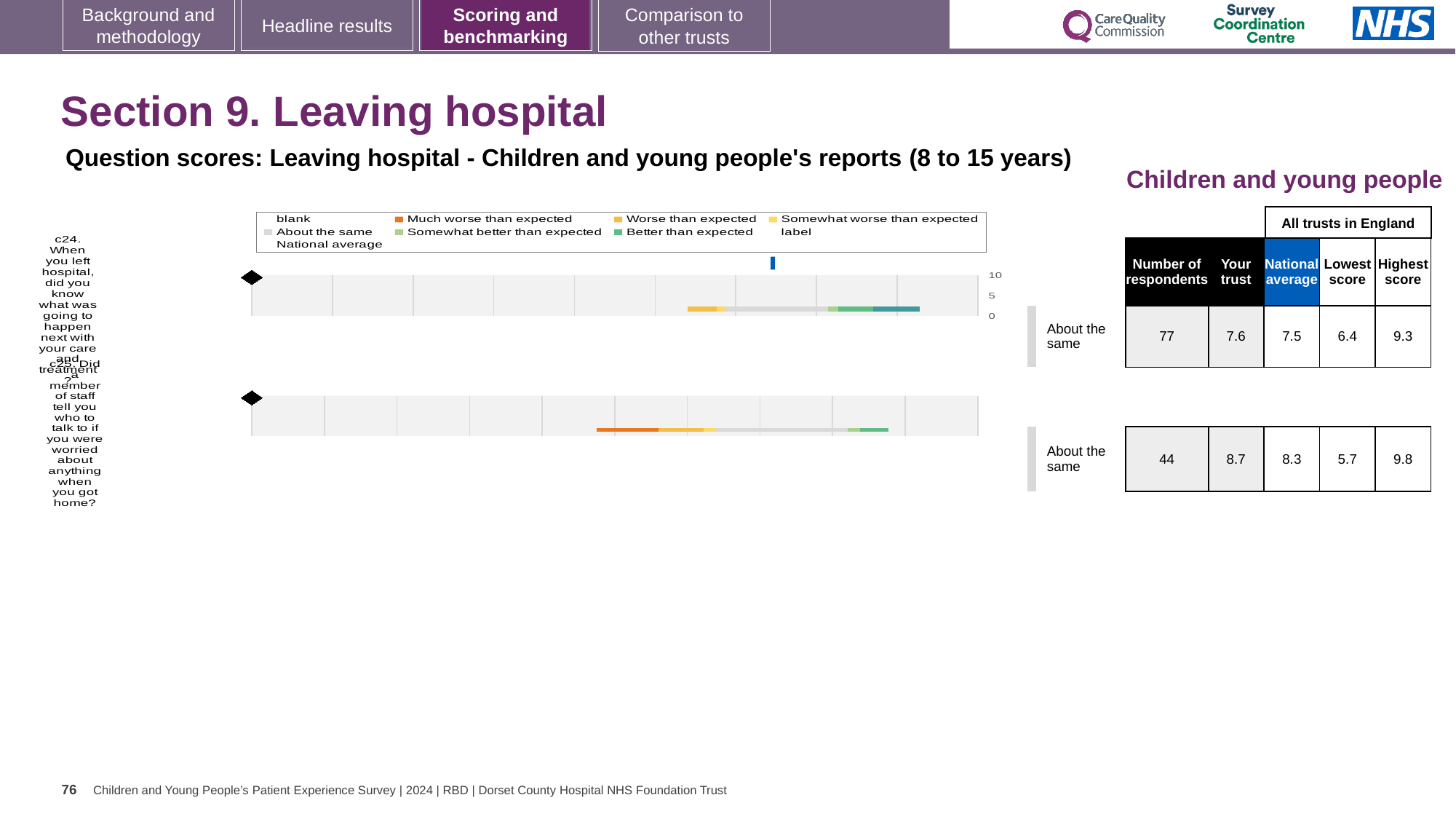
For question c24, what is the 'Your trust' score? 7.6 Which question has the higher 'Your trust' score, c24 or c25? c25 For question c25, what is the lowest score among all trusts in England? 5.7 What benchmark category is question c24 placed in? About the same How many questions (charts) are shown on the slide? 2 For question c25, what is the difference between the highest score and the lowest score across all trusts in England? 4.1 What colour does the legend use for 'Much worse than expected'? orange For question c25, what is the national average score? 8.3 For question c24, what is the difference between the highest score (9.3) and the lowest score (6.4)? 2.9 How many respondents answered question c24? 77 What kind of chart is used to show the question scores for c24 and c25? bar chart For question c25, which is larger: the 'Your trust' score or the national average? Your trust (8.7)